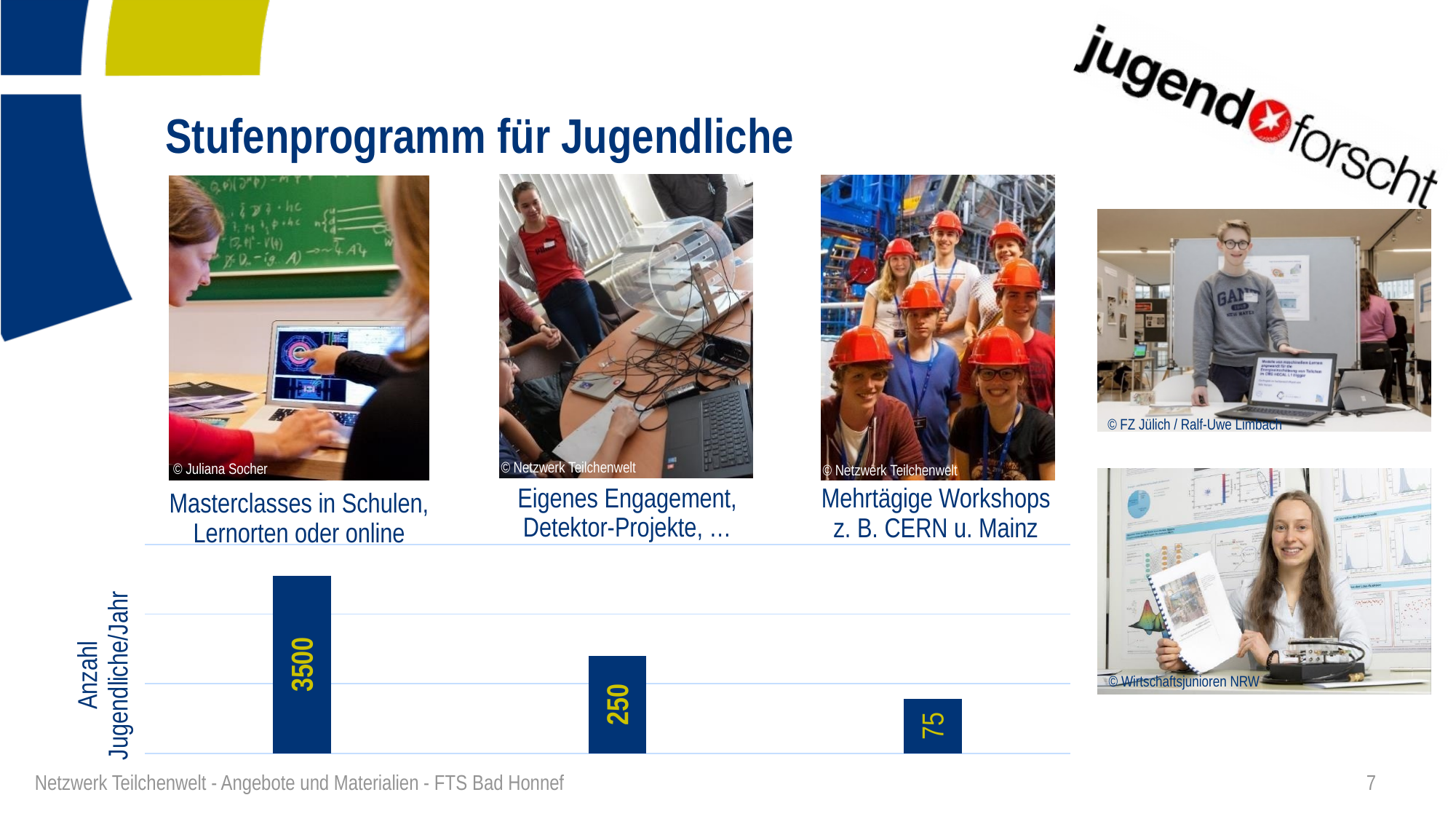
What is the label on the vertical axis of the chart? Anzahl Jugendliche/Jahr What is the difference between the values for Masterclasses and Eigenes Engagement, Detektor-Projekte? 3250 What is the value shown for Eigenes Engagement, Detektor-Projekte? 250 What is the value shown for Mehrtägige Workshops z. B. CERN u. Mainz? 75 What is the difference between the values for Eigenes Engagement, Detektor-Projekte and Mehrtägige Workshops? 175 Which category has the lowest value in the bar chart? Mehrtägige Workshops z. B. CERN u. Mainz How many bars are shown in the chart? 3 What is the value shown for Masterclasses in Schulen, Lernorten oder online? 3500 Do the values rise or fall from left to right across the bars? fall Which category has the highest value in the bar chart? Masterclasses in Schulen, Lernorten oder online Which is larger, the value for Eigenes Engagement, Detektor-Projekte or the value for Mehrtägige Workshops? Eigenes Engagement, Detektor-Projekte What kind of chart is shown on the slide? bar chart